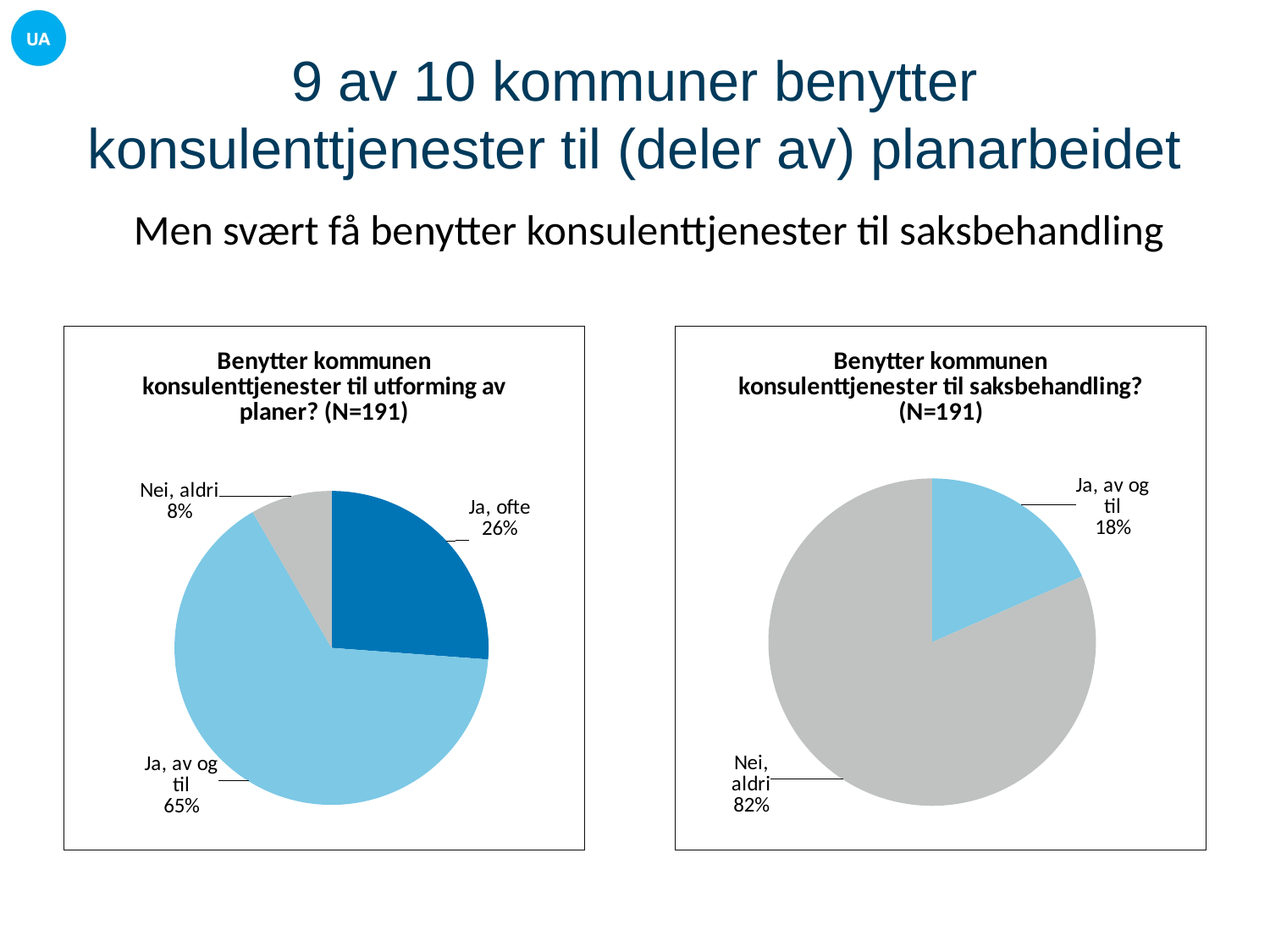
In the right chart (saksbehandling), what share answered "Nei, aldri"? 82% In the left chart (utforming av planer), which answer has the smallest share? Nei, aldri In the left chart (utforming av planer), which answer has the largest share? Ja, av og til What type of chart is the right chart (saksbehandling)? Pie chart In the left chart (utforming av planer), what share answered "Ja, ofte"? 26% In the right chart (saksbehandling), what is the difference in percentage points between "Nei, aldri" and "Ja, av og til"? 64 percentage points In the left chart (utforming av planer), what share answered "Nei, aldri"? 8% In the left chart (utforming av planer), what is the difference in percentage points between "Ja, av og til" and "Ja, ofte"? 39 percentage points In the left chart (utforming av planer), what share of municipalities answered "Ja, av og til"? 65% How many slices does the left chart (utforming av planer) have? 3 In the right chart (saksbehandling), which answer has the largest share? Nei, aldri In the right chart (saksbehandling), what share answered "Ja, av og til"? 18%